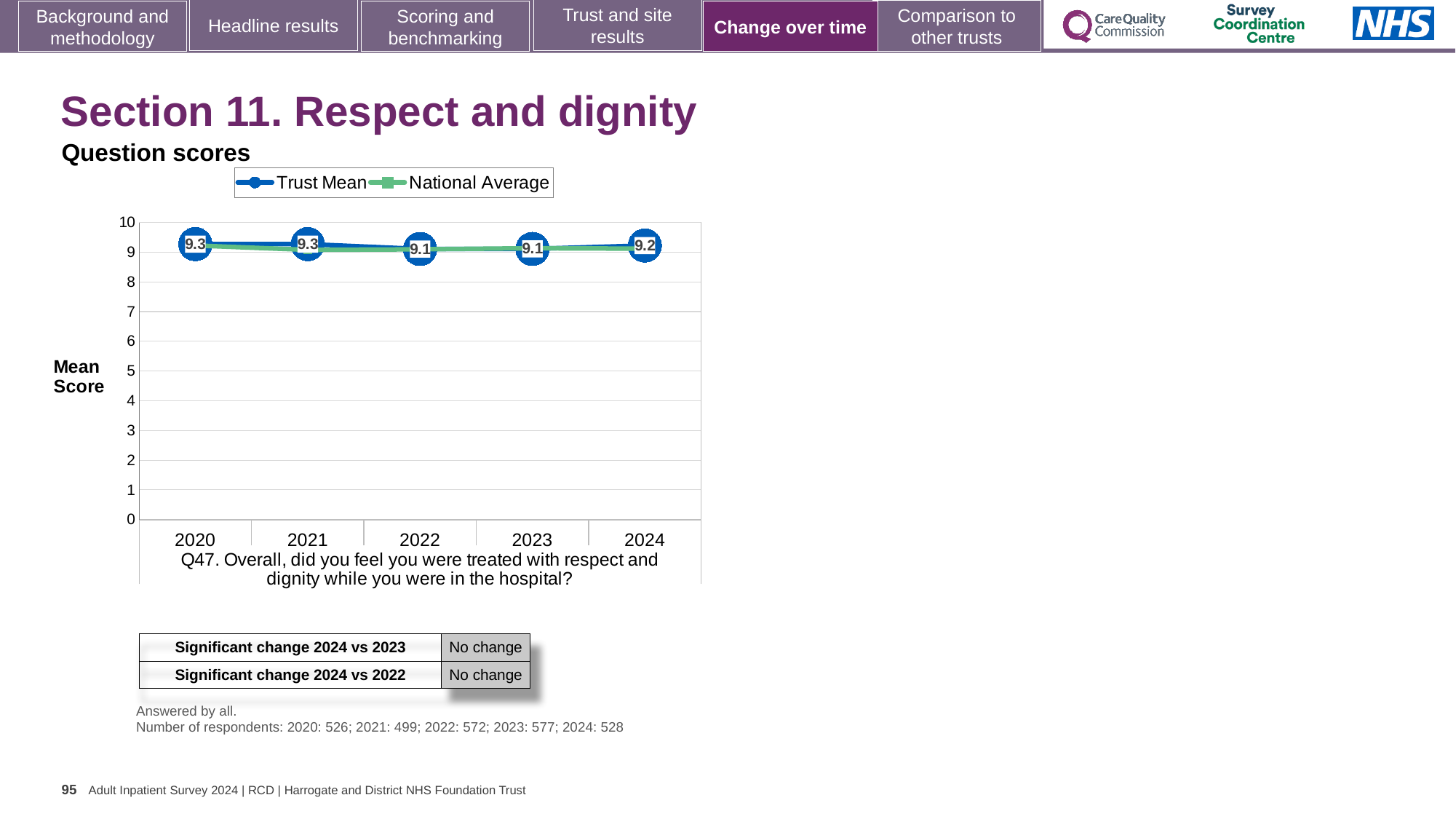
Is the National Average value for 2024 greater or less than 8? greater What is the Trust Mean score for 2022? 9.1 Which year has the larger Trust Mean score, 2021 or 2022? 2021 What is the Trust Mean score for 2023? 9.1 How many years are plotted on the x axis? 5 Does the Trust Mean score rise or fall from 2020 to 2022? fall What is the Trust Mean score for 2024? 9.2 What is the label of the y axis? Mean Score How many series does the legend list? 2 What is the Trust Mean score for 2020? 9.3 What is the difference between the Trust Mean score in 2020 and in 2024? 0.1 What kind of chart is shown? line chart